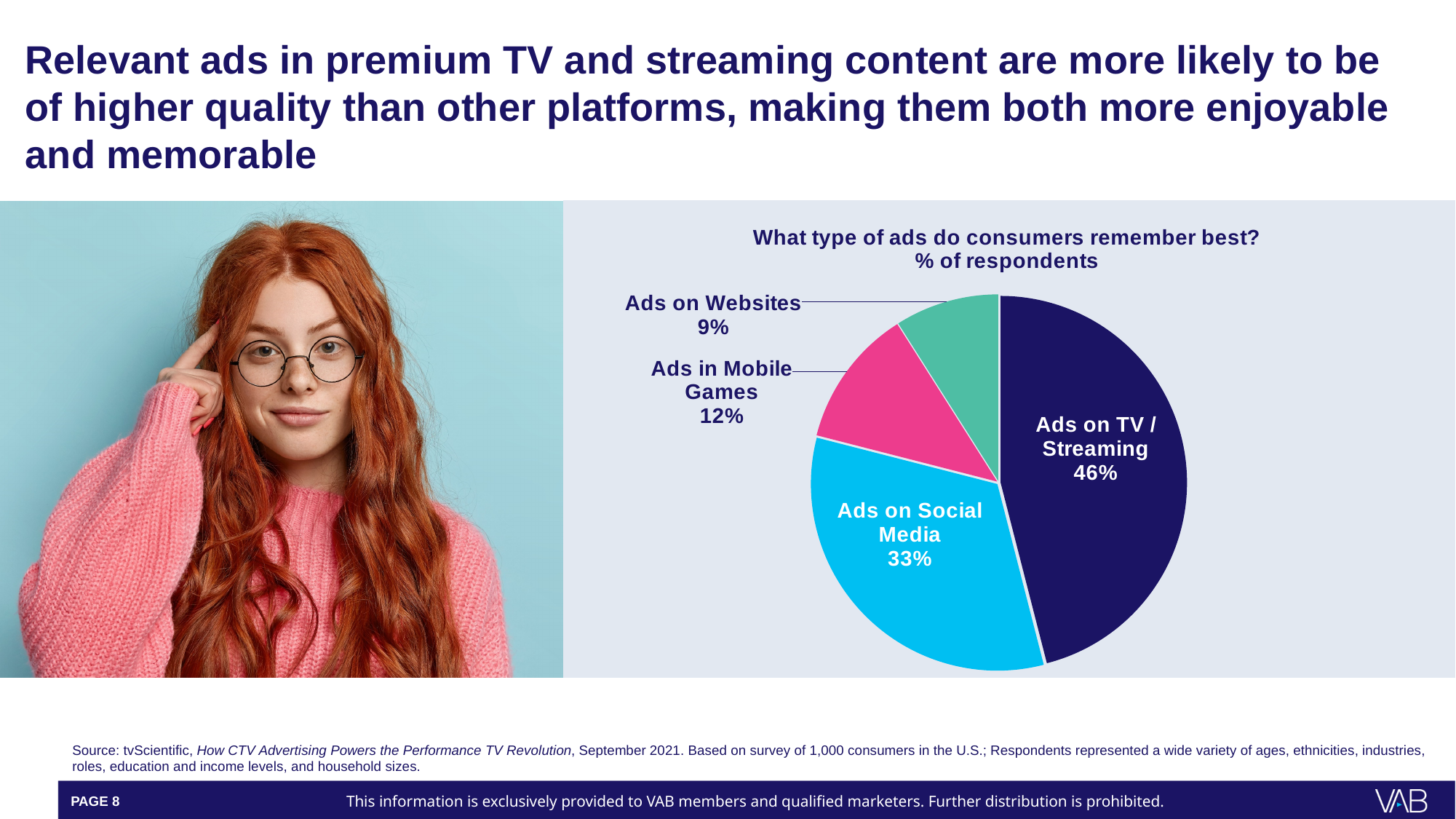
How many ad types are shown in the pie chart? 4 What percentage of respondents remember ads on TV / streaming best? 46% Which has a larger share of respondents: ads in mobile games or ads on websites? Ads in Mobile Games What kind of chart is shown on the slide? Pie chart What is the difference in percentage points between ads on TV / streaming and ads on social media? 13 What colour is the slice for ads on social media? Light blue Which type of ad has the smallest share of respondents? Ads on Websites What percentage of respondents remember ads on websites best? 9% What percentage of respondents remember ads on social media best? 33% Which type of ad has the largest share of respondents? Ads on TV / Streaming What percentage of respondents remember ads in mobile games best? 12% What is the title of the chart? What type of ads do consumers remember best?